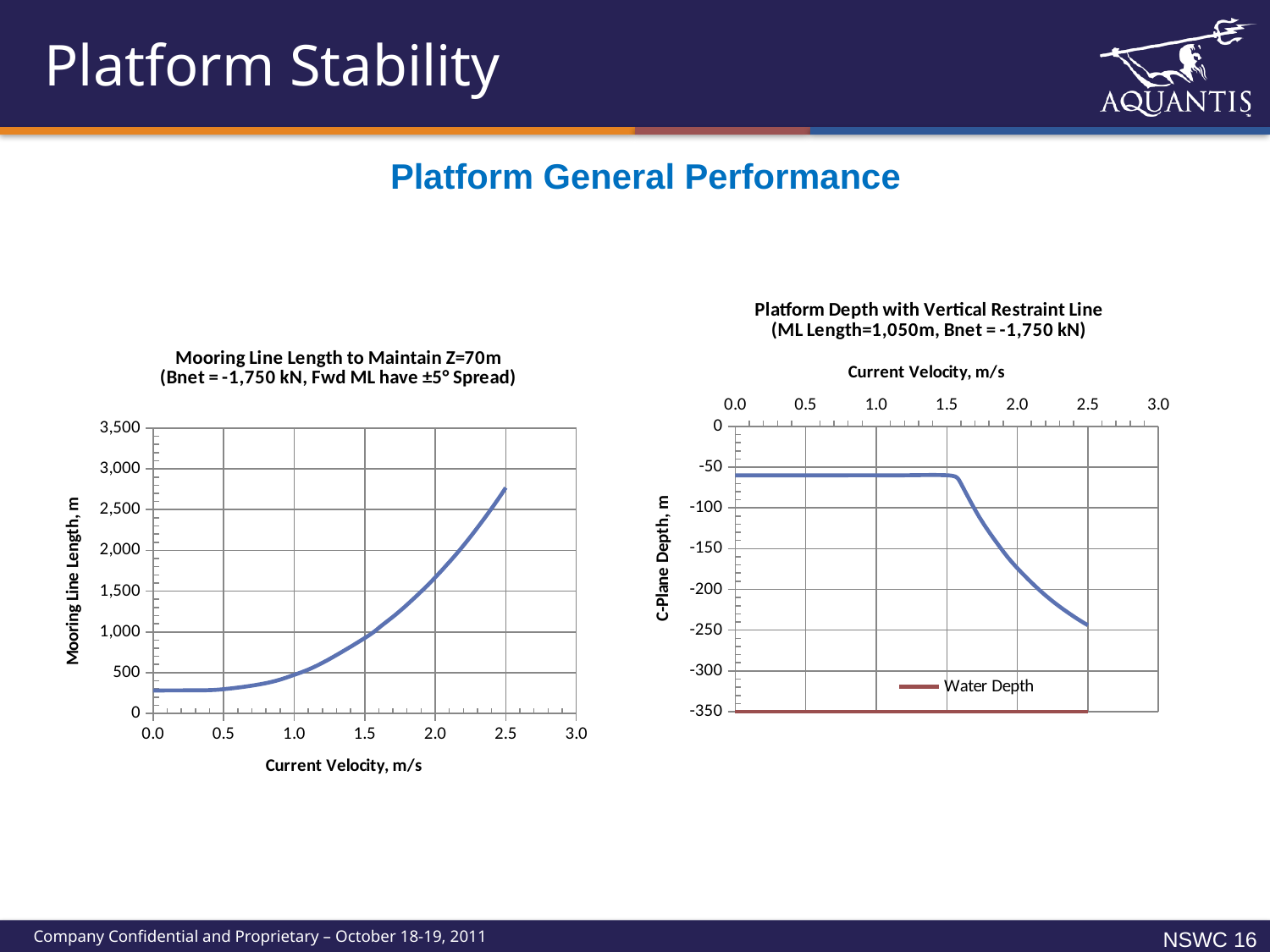
In the left chart, 'Mooring Line Length to Maintain Z=70m', does the mooring line length rise or fall as current velocity increases? Rise What kind of chart is the right chart, 'Platform Depth with Vertical Restraint Line'? Line chart How many series does the legend of the right chart, 'Platform Depth with Vertical Restraint Line', list? 1 What is the y-axis label of the left chart, 'Mooring Line Length to Maintain Z=70m'? Mooring Line Length, m In the left chart, 'Mooring Line Length to Maintain Z=70m', is the mooring line length at a current velocity of 0.0 m/s greater or less than 500? less What kind of chart is the left chart, 'Mooring Line Length to Maintain Z=70m'? Line chart In the right chart, 'Platform Depth with Vertical Restraint Line', at what C-Plane Depth value does the Water Depth line sit? -350 In the right chart, 'Platform Depth with Vertical Restraint Line', does the C-Plane Depth rise or fall as current velocity increases beyond 1.5 m/s? Fall In the left chart, 'Mooring Line Length to Maintain Z=70m', is the mooring line length at a current velocity of 2.5 m/s greater or less than 2,500? greater In the right chart, 'Platform Depth with Vertical Restraint Line', is the C-Plane Depth at a current velocity of 1.0 m/s greater or less than -100? greater